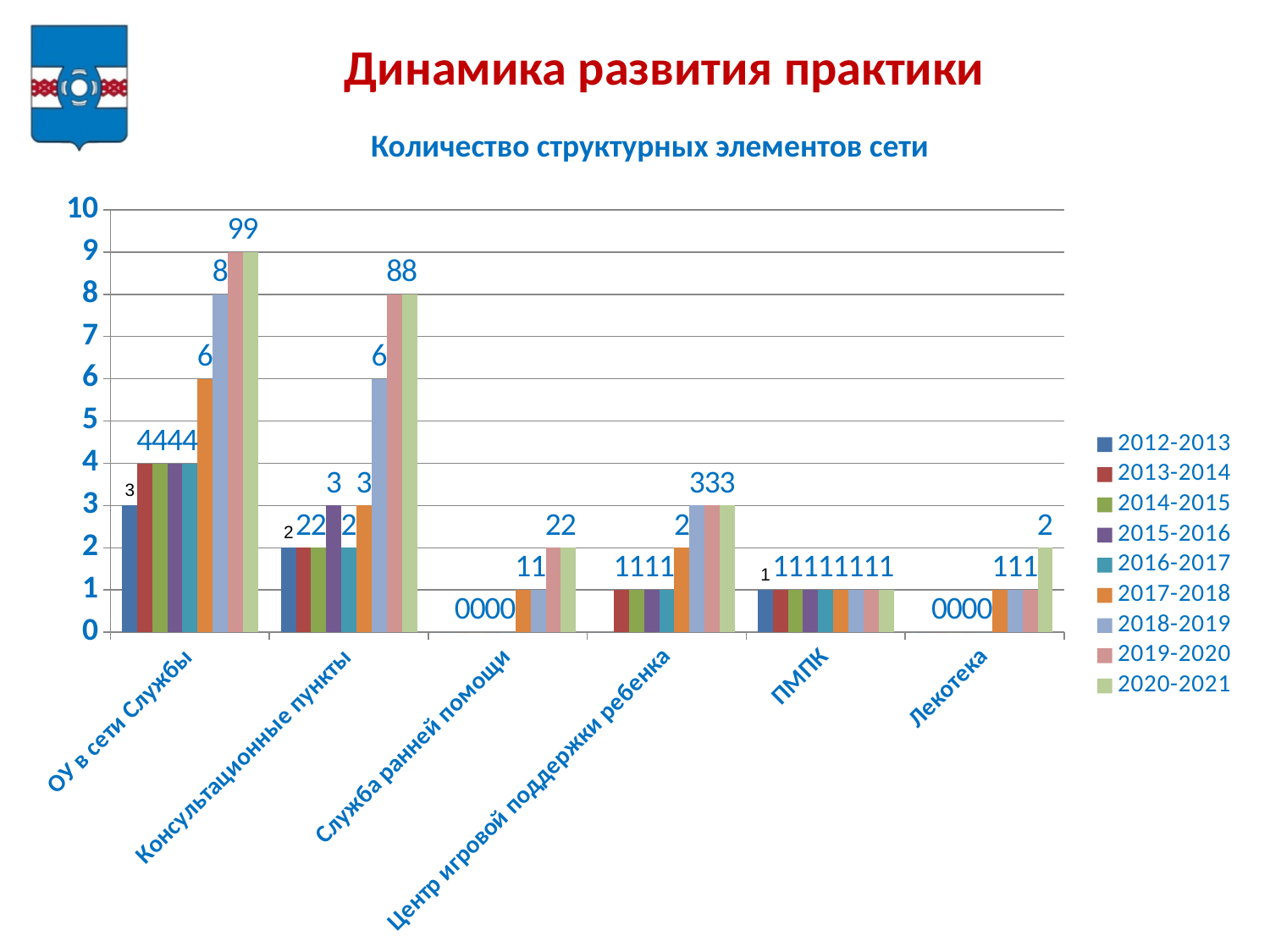
What is the value for Консультационные пункты in 2018-2019? 6 In 2019-2020, which is larger: Консультационные пункты or Центр игровой поддержки ребенка? Консультационные пункты Which category has the highest value in 2020-2021? ОУ в сети Службы How many categories are shown on the x axis? 6 What is the value for Лекотека in 2020-2021? 2 What is the chart's subtitle shown above the plot? Количество структурных элементов сети How many series does the legend list? 9 What is the value for ОУ в сети Службы in 2020-2021? 9 Do the values for ОУ в сети Службы rise or fall from 2012-2013 to 2020-2021? rise What kind of chart is shown on the slide? bar chart What is the difference between the 2020-2021 and 2012-2013 values for ОУ в сети Службы? 6 What is the value for ОУ в сети Службы in 2012-2013? 3